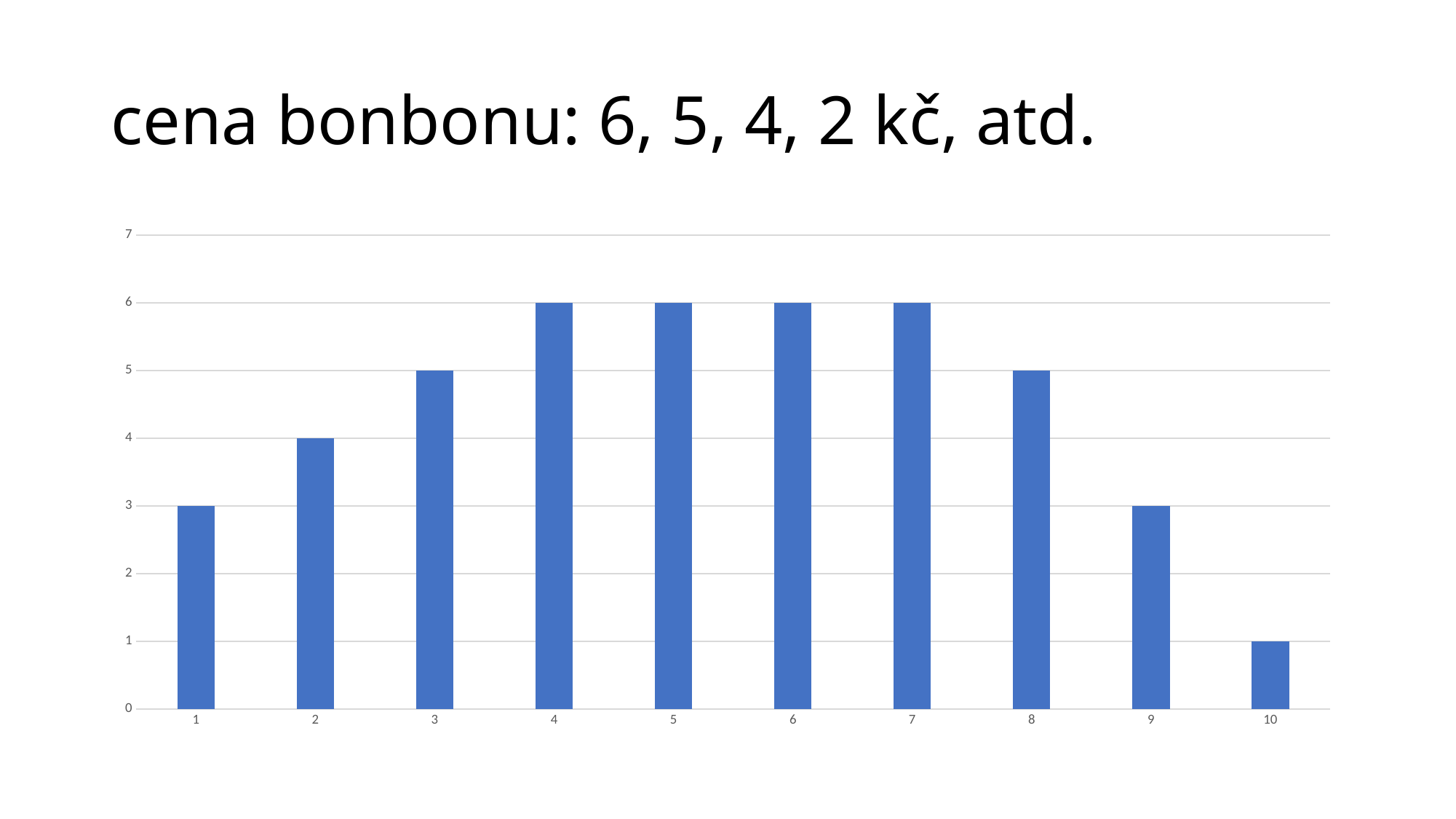
What is the value for category 10? 1 Do the values rise or fall from category 7 to category 10? fall What kind of chart is shown on the slide? bar chart What is the title text at the top of the slide? cena bonbonu: 6, 5, 4, 2 kč, atd. Is the value for category 7 greater or less than 5? greater Which has the larger value, category 2 or category 9? 2 What is the value for category 8? 5 Which category has the lowest value? 10 What is the difference between the values for category 4 and category 2? 2 What is the value for category 1? 3 What is the value for category 3? 5 How many categories are shown on the x axis? 10